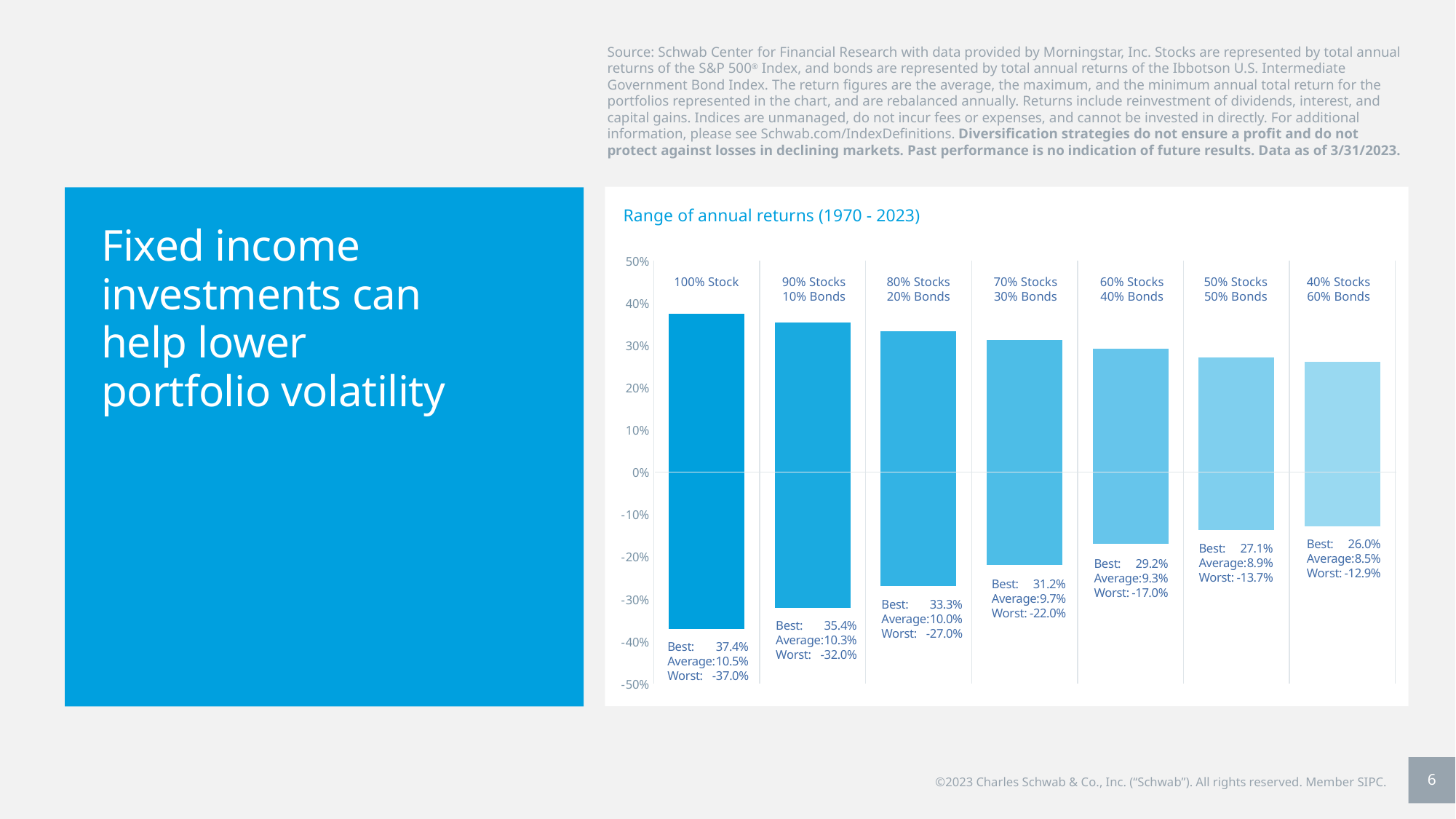
Which portfolio has the highest best annual return? 100% Stock What is the difference between the best returns of the 100% Stock portfolio and the 40% Stocks / 60% Bonds portfolio? 11.4% Which portfolio has a higher average annual return, 90% Stocks / 10% Bonds or 50% Stocks / 50% Bonds? 90% Stocks / 10% Bonds What is the title of the chart? Range of annual returns (1970 - 2023) What is the worst annual return for the 80% Stocks / 20% Bonds portfolio? -27.0% What is the average annual return for the 60% Stocks / 40% Bonds portfolio? 9.3% How many portfolio allocations are shown in the chart? 7 Is the best return for the 70% Stocks / 30% Bonds portfolio greater or less than 30%? greater What kind of chart is shown on the slide? Bar chart What is the best annual return for the 100% Stock portfolio? 37.4% How do the best annual returns change as the bond allocation increases from left to right? They fall Which portfolio has the lowest worst annual return? 100% Stock